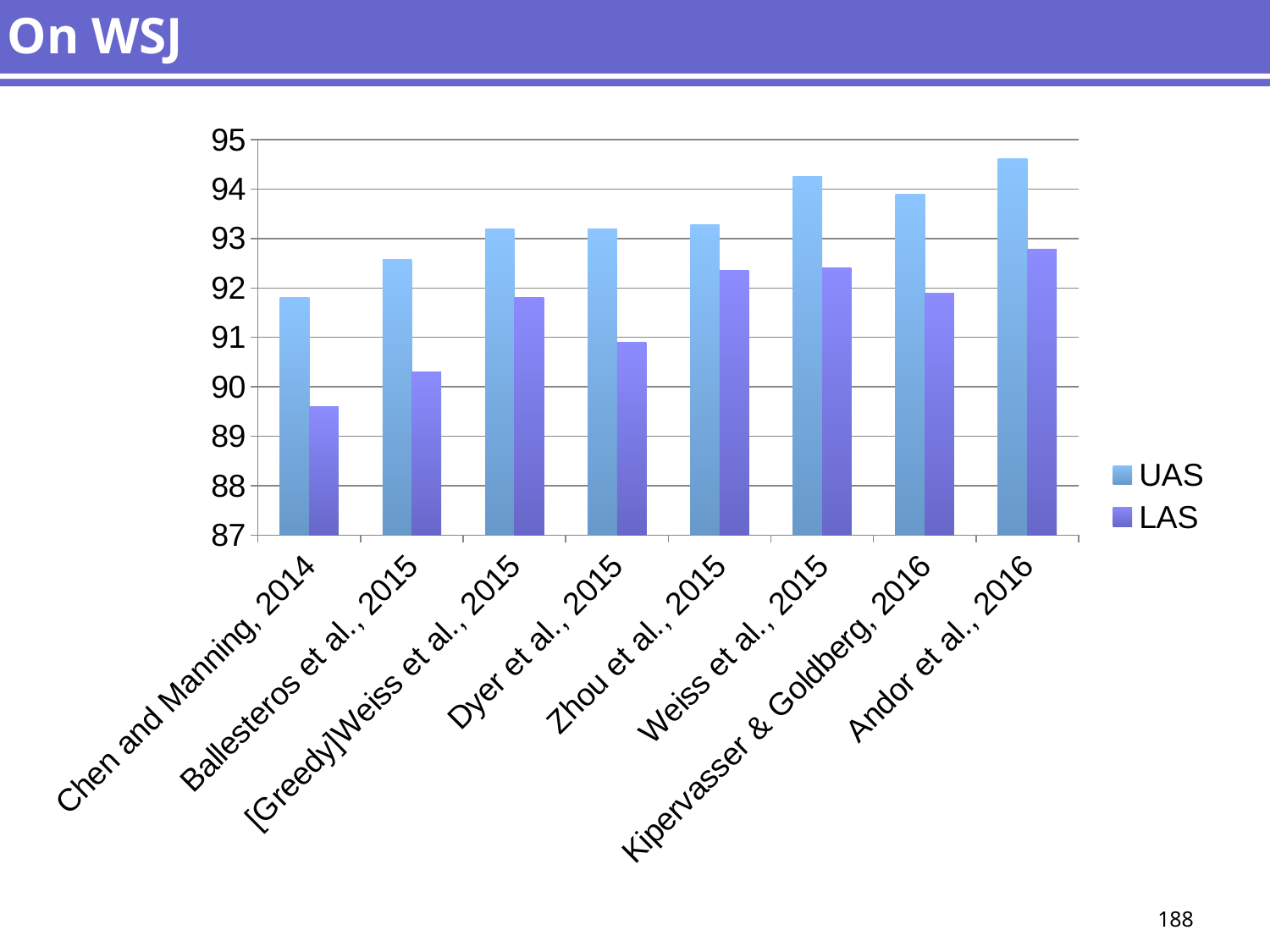
What kind of chart is shown on the slide? bar chart Is the UAS value for Weiss et al., 2015 greater or less than 94? greater Is the LAS value for Chen and Manning, 2014 greater or less than 90? less How many series does the legend list? 2 Is the UAS value for Chen and Manning, 2014 greater or less than 92? less Which is larger, the UAS for Weiss et al., 2015 or the UAS for Kipervasser & Goldberg, 2016? Weiss et al., 2015 Which system has the lowest UAS? Chen and Manning, 2014 What are the two series named in the legend? UAS and LAS Which system has the lowest LAS? Chen and Manning, 2014 Which system has the highest UAS? Andor et al., 2016 Which system has the highest LAS? Andor et al., 2016 How many categories (systems) are shown on the x axis? 8